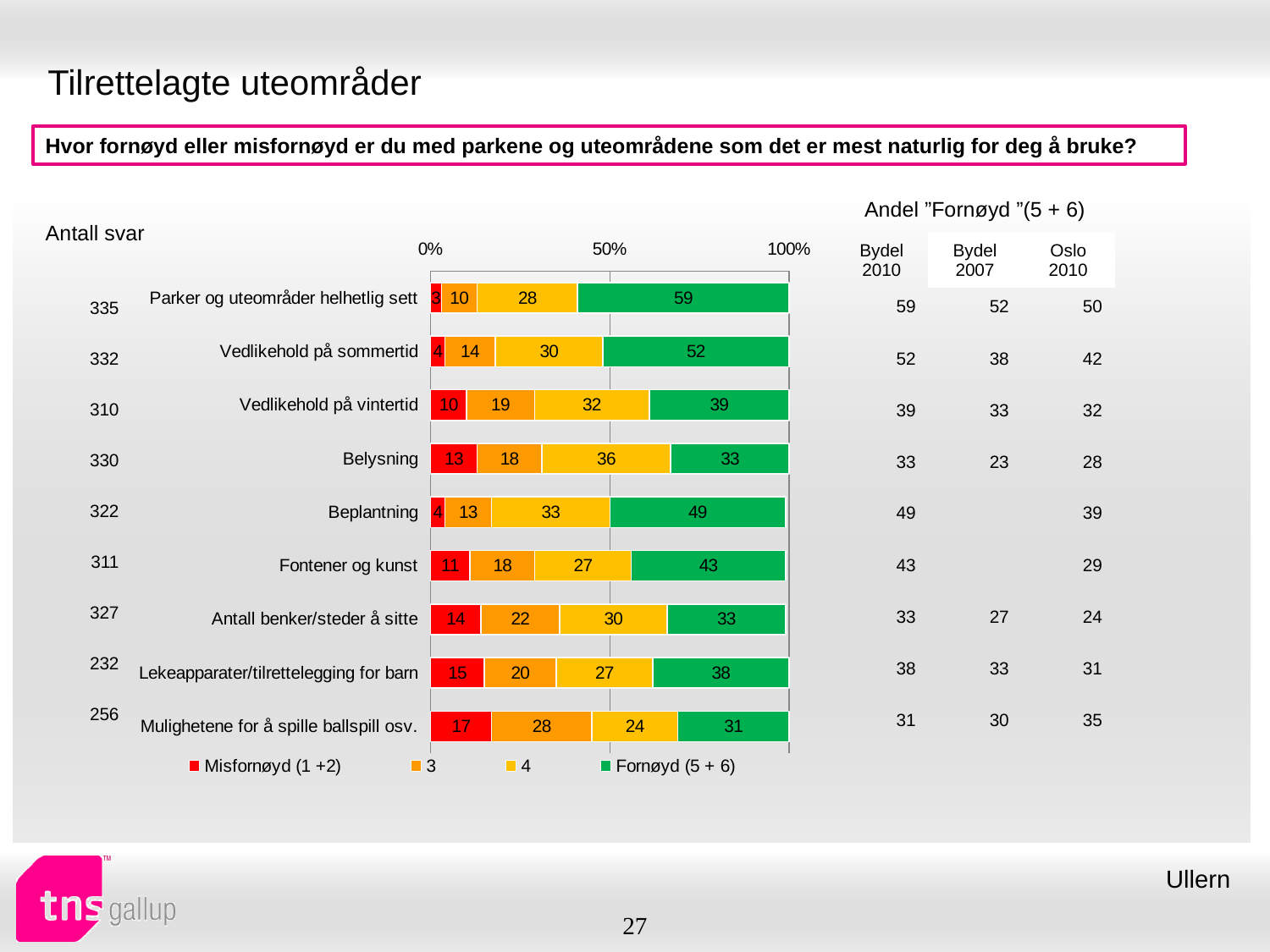
What is the Misfornøyd (1 +2) value for Mulighetene for å spille ballspill osv.? 17 How many categories are plotted in the chart? 9 What is the difference between the Fornøyd (5 + 6) values for Vedlikehold på sommertid and Vedlikehold på vintertid? 13 What kind of chart is shown on the slide? stacked bar chart What is the total of the stacked bar for Beplantning? 99 Which category has the lowest Fornøyd (5 + 6) value? Mulighetene for å spille ballspill osv. Which has a larger Misfornøyd (1 +2) value, Antall benker/steder å sitte or Fontener og kunst? Antall benker/steder å sitte What is the value of series 4 for Belysning? 36 Which category has the highest Fornøyd (5 + 6) value? Parker og uteområder helhetlig sett Which series is shown in green in the chart? Fornøyd (5 + 6) How many series does the chart legend list? 4 What is the Fornøyd (5 + 6) value for Parker og uteområder helhetlig sett? 59